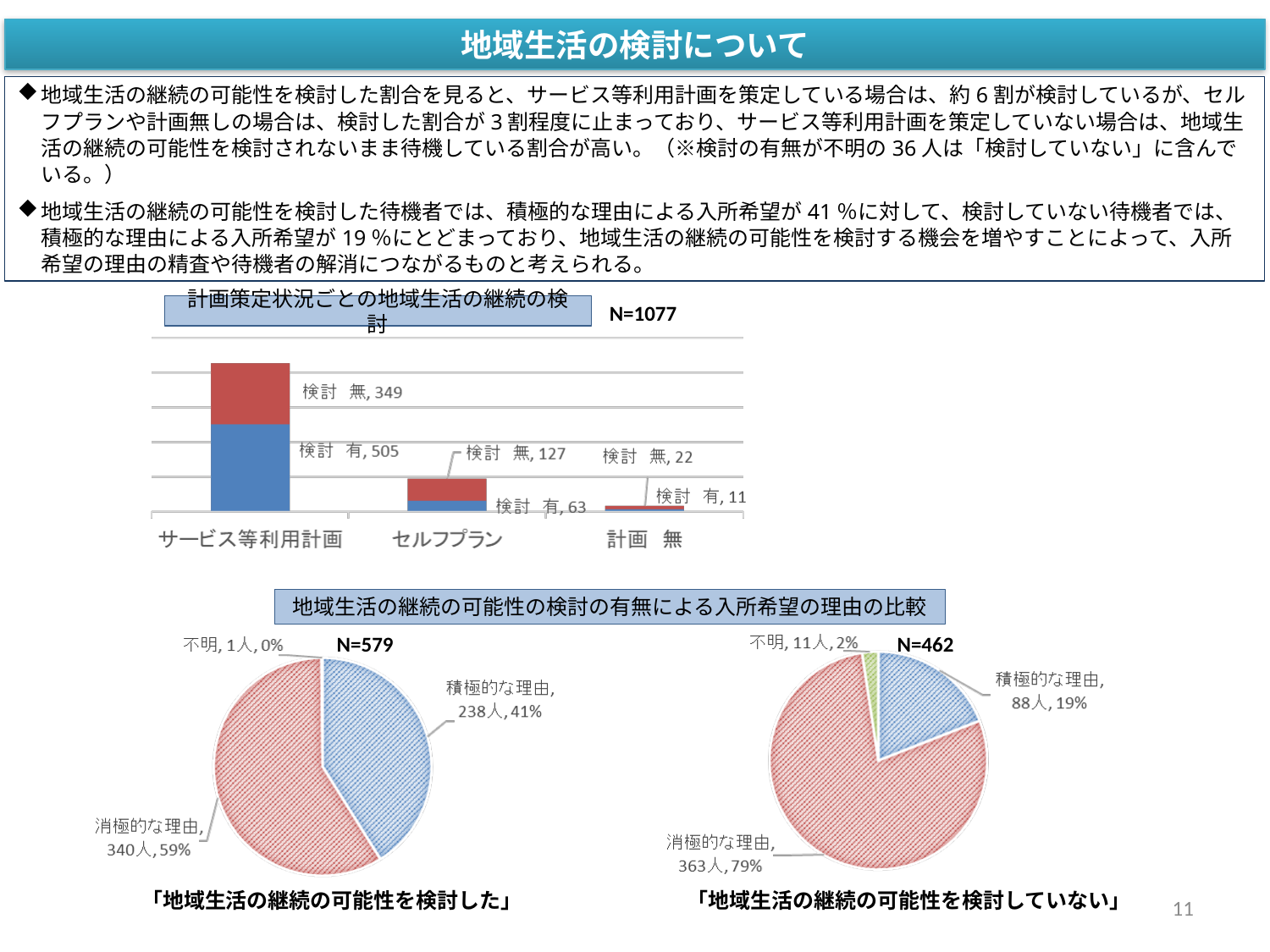
In the bar chart 計画策定状況ごとの地域生活の継続の検討, which category has the highest total? サービス等利用計画 In the right pie chart 「地域生活の継続の可能性を検討していない」, which slice is the smallest? 不明 In the bar chart 計画策定状況ごとの地域生活の継続の検討, what is the total of the stacked bar for 計画 無? 33 In the left pie chart 「地域生活の継続の可能性を検討した」, what share does 消極的な理由 have? 59% In the bar chart 計画策定状況ごとの地域生活の継続の検討, what is the value of 検討 有 for サービス等利用計画? 505 In the bar chart 計画策定状況ごとの地域生活の継続の検討, how many categories are shown on the x axis? 3 In the bar chart 計画策定状況ごとの地域生活の継続の検討, what is the difference between 検討 有 and 検討 無 for サービス等利用計画? 156 What type of chart is 計画策定状況ごとの地域生活の継続の検討? Stacked bar chart In the bar chart 計画策定状況ごとの地域生活の継続の検討, what is the value of 検討 無 for セルフプラン? 127 In the bar chart 計画策定状況ごとの地域生活の継続の検討, what is the total of the stacked bar for サービス等利用計画? 854 In the right pie chart 「地域生活の継続の可能性を検討していない」, how many people are in 積極的な理由? 88人 What is the N value shown for the left pie chart 「地域生活の継続の可能性を検討した」? N=579